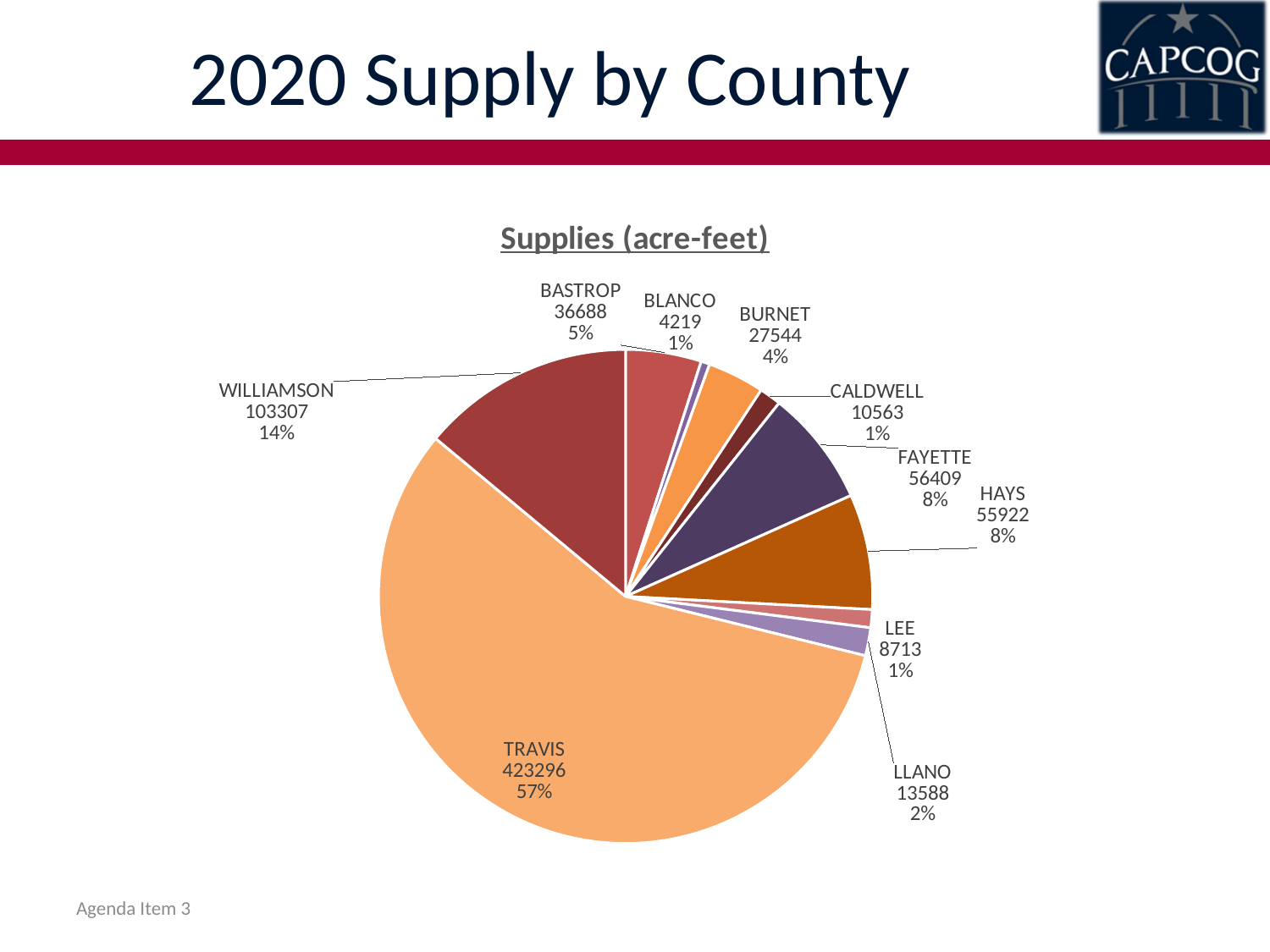
What share of the pie does Fayette county represent? 8% What is the supply value for Travis county? 423296 What is the difference between the supply values of Fayette and Hays? 487 What share of the pie does Williamson county represent? 14% What kind of chart is shown on the slide? Pie chart Which has a larger supply value, Bastrop or Llano? Bastrop Which county has the largest share of the pie? Travis What is the title of the chart? Supplies (acre-feet) How many counties are shown in the pie chart? 10 Which county has the smallest supply value? Blanco What is the supply value for Williamson county? 103307 What is the supply value for Burnet county? 27544